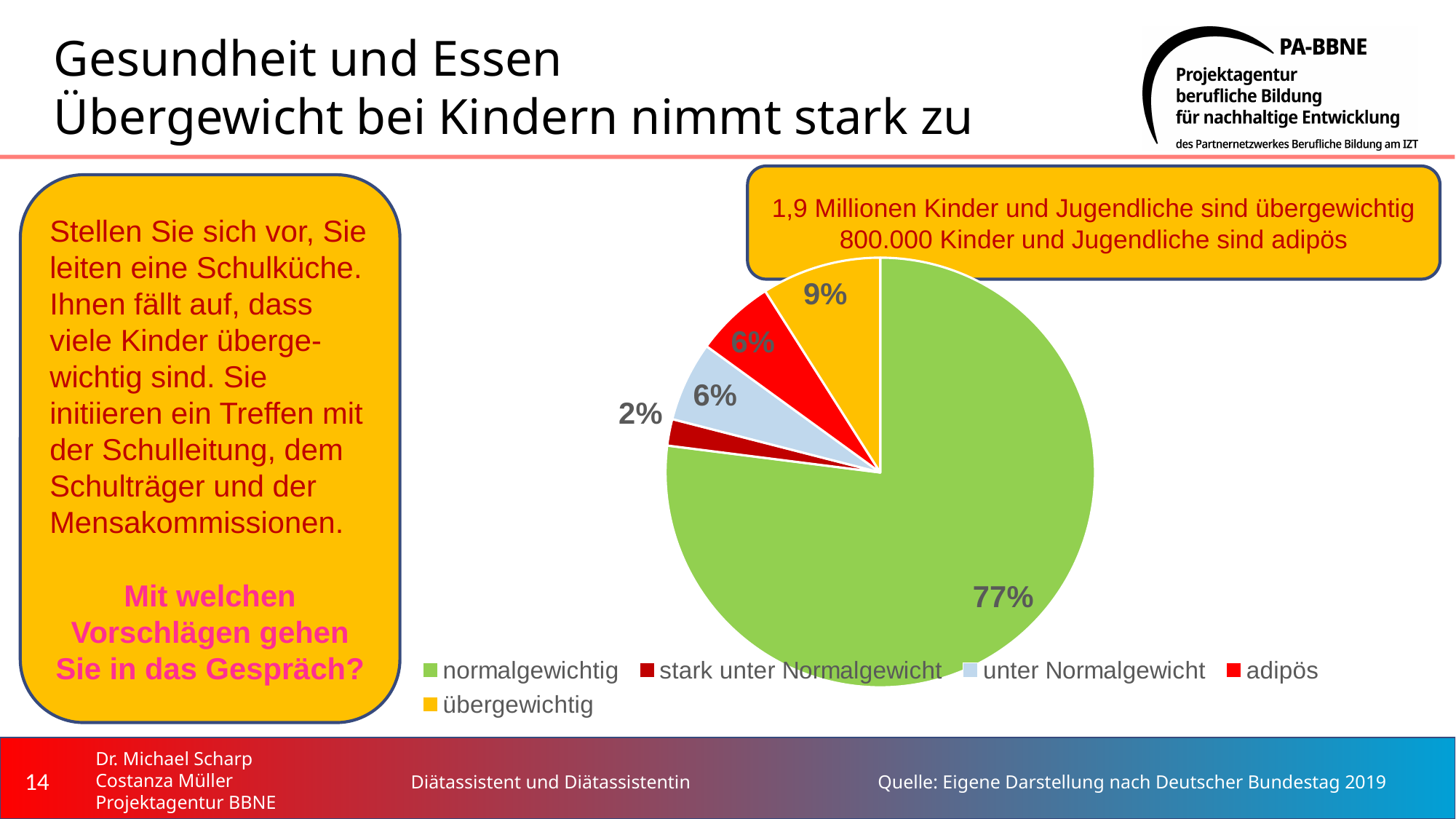
What share of the pie is labelled "stark unter Normalgewicht"? 2% What is the difference between the share for "normalgewichtig" and the share for "übergewichtig"? 68% What colour is the slice for "übergewichtig"? yellow What share of the pie is labelled "normalgewichtig"? 77% What kind of chart is shown on the slide? pie chart What share of the pie is labelled "adipös"? 6% What share of the pie is labelled "unter Normalgewicht"? 6% Which is larger, the share for "übergewichtig" or the share for "adipös"? übergewichtig Which category has the largest slice of the pie? normalgewichtig What share of the pie is labelled "übergewichtig"? 9% Which category has the smallest slice of the pie? stark unter Normalgewicht How many categories does the legend of the pie chart list? 5